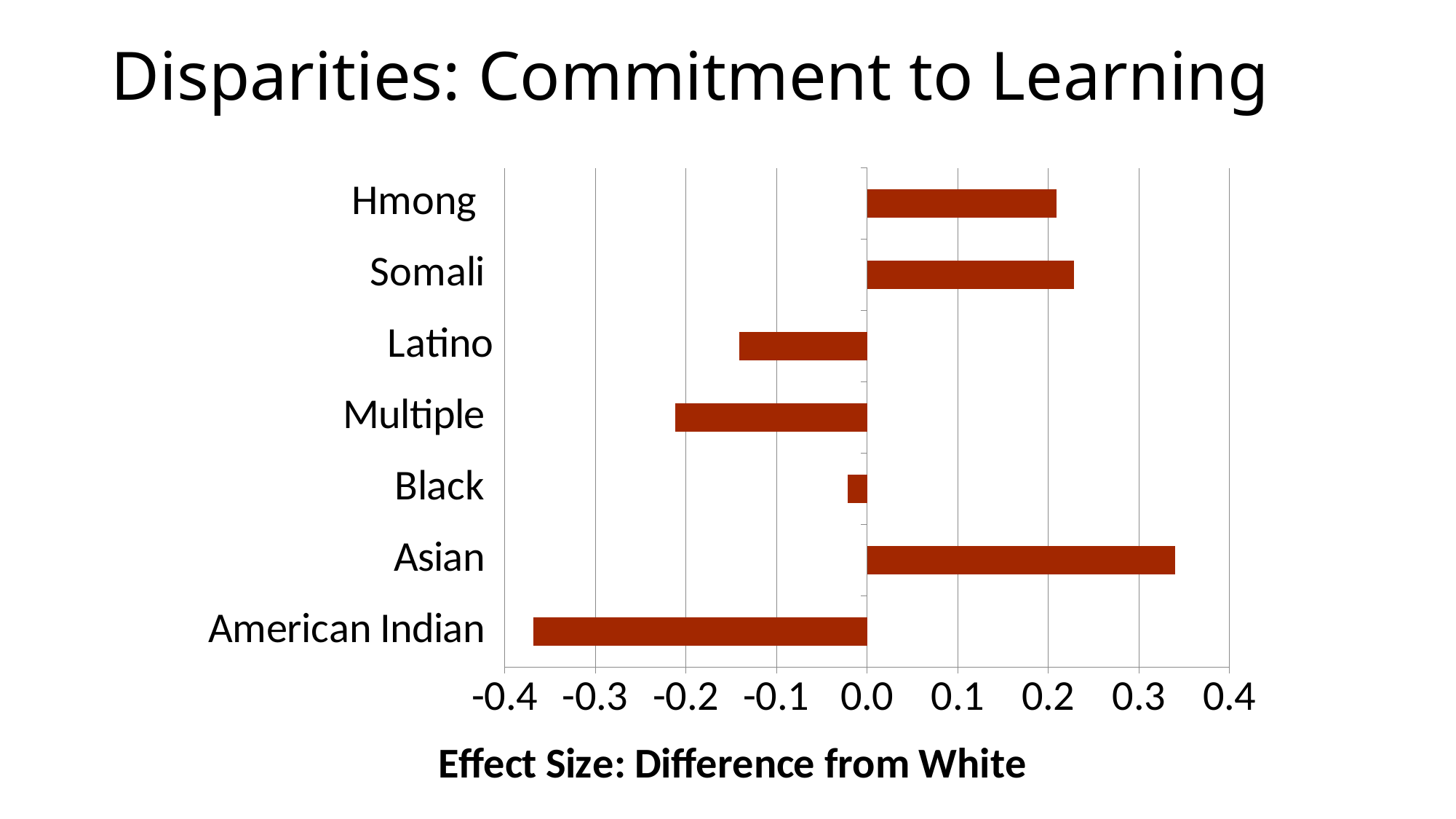
Which group has the highest effect size? Asian Is the value for Black greater or less than -0.1? greater Which group has the lowest effect size? American Indian Is the value for American Indian greater or less than -0.3? less What kind of chart is shown on the slide? bar chart How many groups are plotted in the chart? 7 Is the value for Hmong greater or less than 0.1? greater Which has the larger effect size, Latino or Multiple? Latino Which has the larger effect size, Asian or Hmong? Asian What is the label on the horizontal axis of the chart? Effect Size: Difference from White